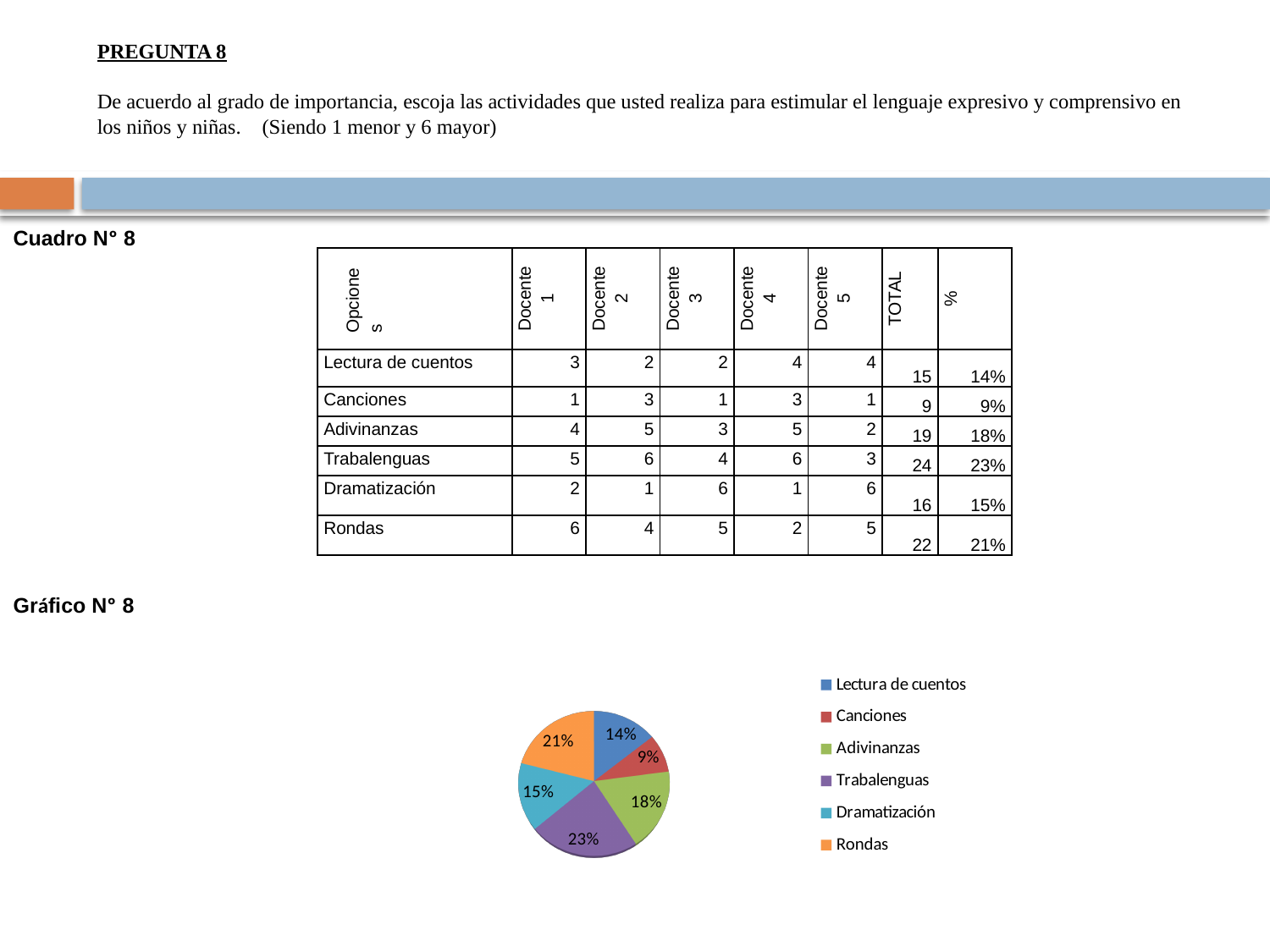
In Gráfico N° 8, which category is shown in orange in the legend? Rondas In Gráfico N° 8, which slice is larger: Adivinanzas or Lectura de cuentos? Adivinanzas In Gráfico N° 8, what percentage is shown for Canciones? 9% How many slices does the pie in Gráfico N° 8 have? 6 In Gráfico N° 8, what is the difference in percentage points between Trabalenguas and Canciones? 14 In Gráfico N° 8, what percentage is shown for Rondas? 21% Which category has the smallest slice in Gráfico N° 8? Canciones Which category has the largest slice in Gráfico N° 8? Trabalenguas In Gráfico N° 8, what percentage is shown for Dramatización? 15% How many entries does the legend of Gráfico N° 8 list? 6 What type of chart is Gráfico N° 8? pie chart In Gráfico N° 8, what share of the pie does Trabalenguas have? 23%